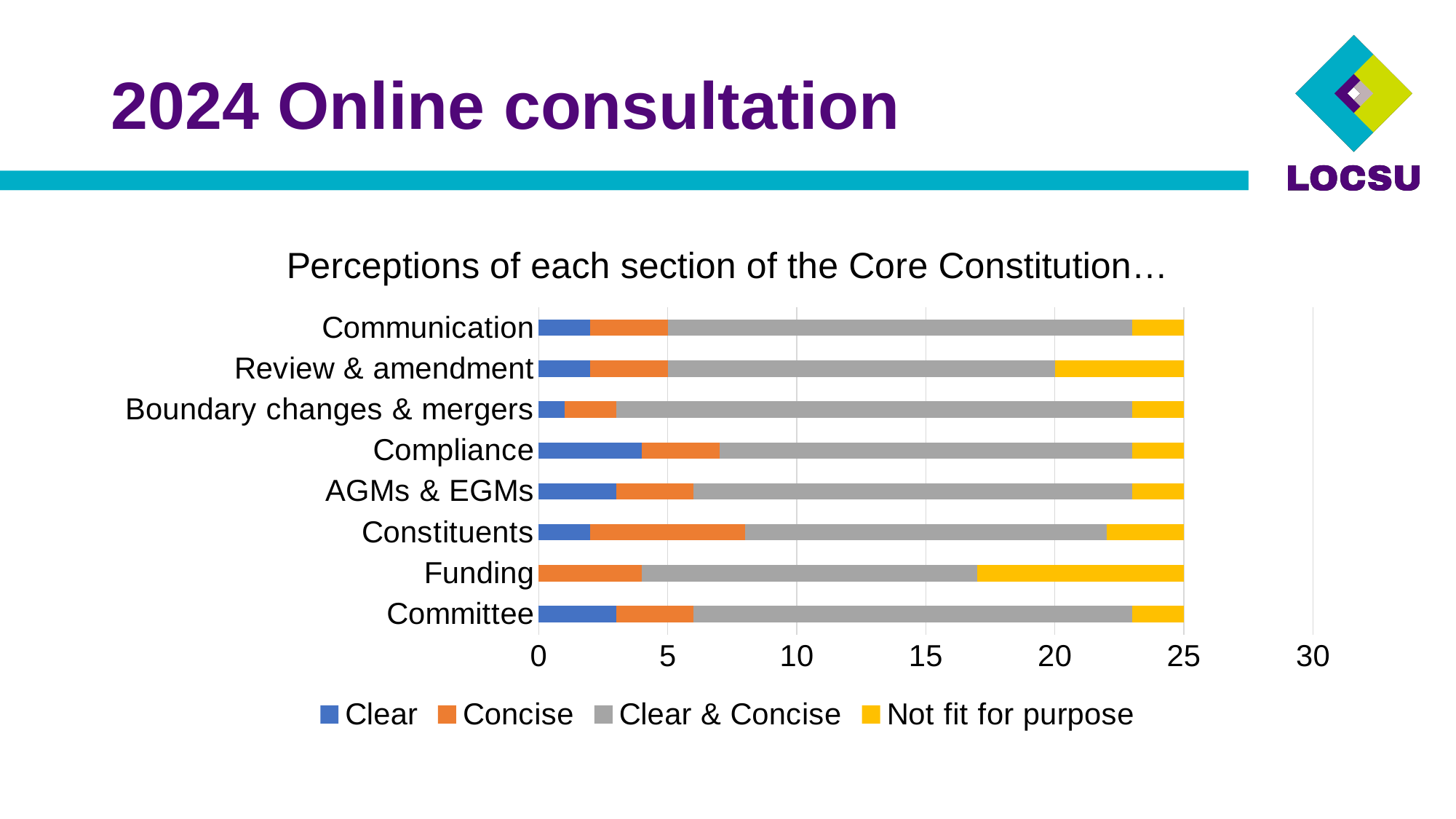
Which colour represents the 'Not fit for purpose' series in the legend? Yellow Is the 'Clear & Concise' value for Funding greater or less than 10? greater What is the total of the stacked bar for Committee? 25 Which section has the smallest 'Clear' segment? Funding How many series does the legend list? 4 Is the 'Not fit for purpose' value for Funding greater or less than 5? greater Which section has the largest 'Not fit for purpose' segment? Funding How many sections (categories) are plotted in the chart? 8 What kind of chart is shown on the slide? Stacked bar chart Which section has the larger 'Clear' segment, Compliance or Boundary changes & mergers? Compliance What is the total of the stacked bar for Funding? 25 What is the title of the chart? Perceptions of each section of the Core Constitution…